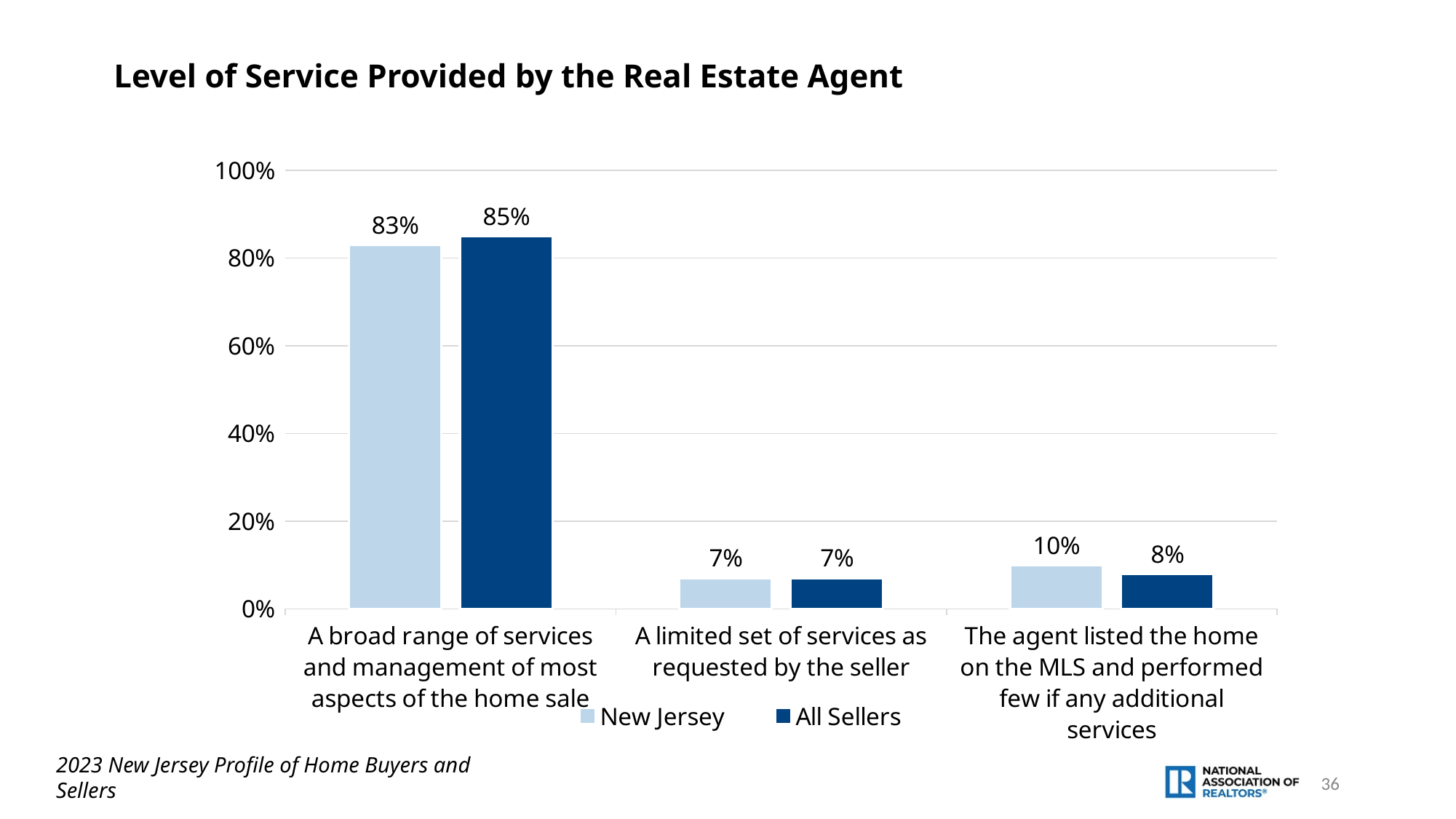
What is the title of the chart? Level of Service Provided by the Real Estate Agent Which category has the highest New Jersey value? A broad range of services and management of most aspects of the home sale What is the New Jersey value for 'A broad range of services and management of most aspects of the home sale'? 83% How many categories are shown on the x axis? 3 What kind of chart is shown on the slide? Bar chart What is the difference between the All Sellers and New Jersey values for 'A broad range of services and management of most aspects of the home sale'? 2% What is the All Sellers value for 'A broad range of services and management of most aspects of the home sale'? 85% For 'The agent listed the home on the MLS and performed few if any additional services', which is larger: New Jersey or All Sellers? New Jersey What is the New Jersey value for 'The agent listed the home on the MLS and performed few if any additional services'? 10% How many series does the legend list? 2 Which category has the lowest All Sellers value? A limited set of services as requested by the seller What is the All Sellers value for 'A limited set of services as requested by the seller'? 7%